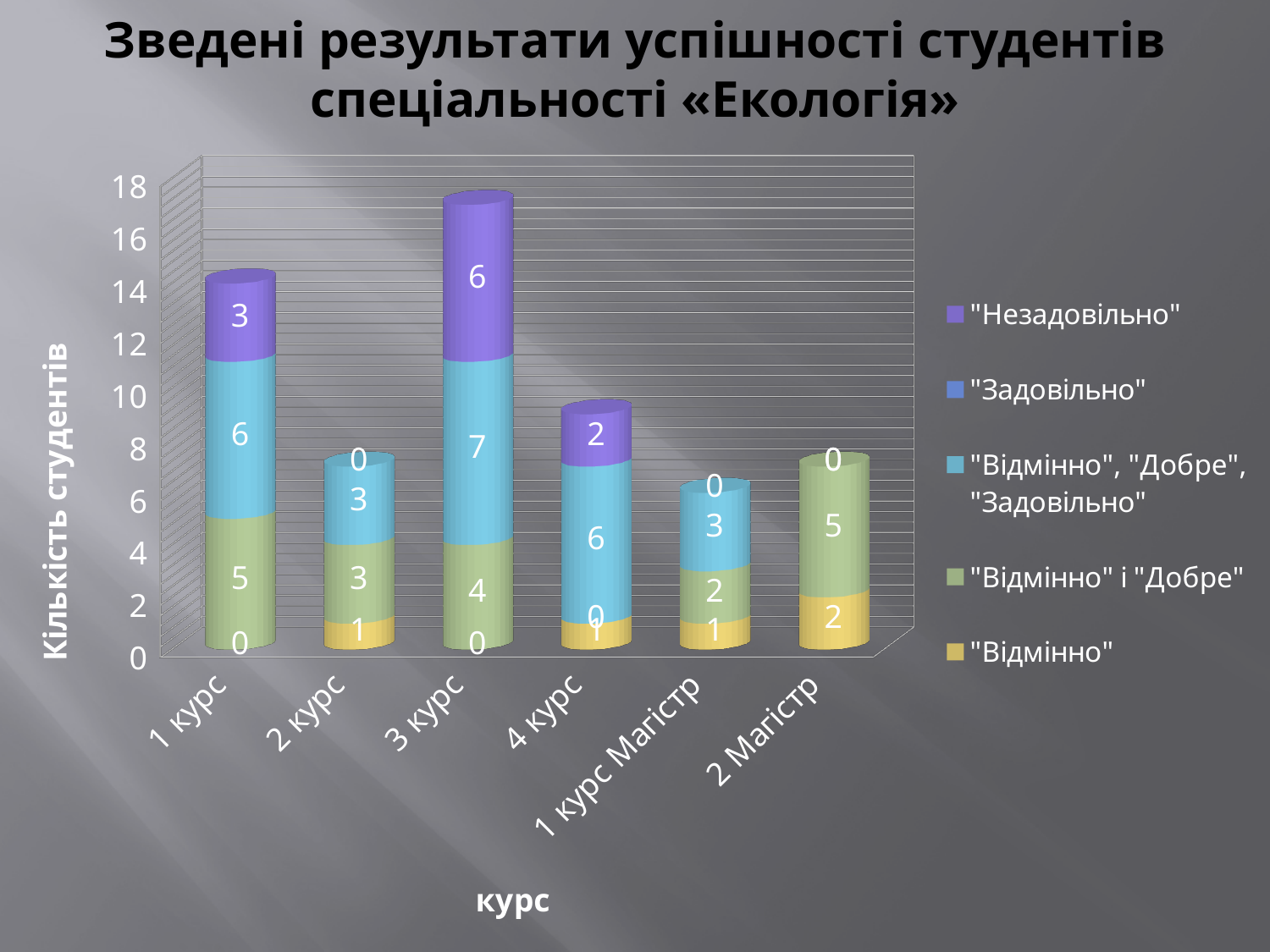
Which has the larger "Відмінно" і "Добре" value, 2 Магістр or 3 курс? 2 Магістр What kind of chart is shown on the slide? Stacked bar chart What is the difference between the "Незадовільно" values for 3 курс and 1 курс? 3 How many course categories are shown on the x axis? 6 What is the title of the vertical axis? Кількість студентів Which course has the tallest stacked bar? 3 курс What is the total of the stacked bar for 3 курс? 17 What is the value of "Відмінно" for 2 Магістр? 2 What is the value of "Відмінно", "Добре", "Задовільно" for 4 курс? 6 How many series does the legend list? 5 What is the value of "Відмінно" і "Добре" for 1 курс? 5 What is the value of "Незадовільно" for 3 курс? 6